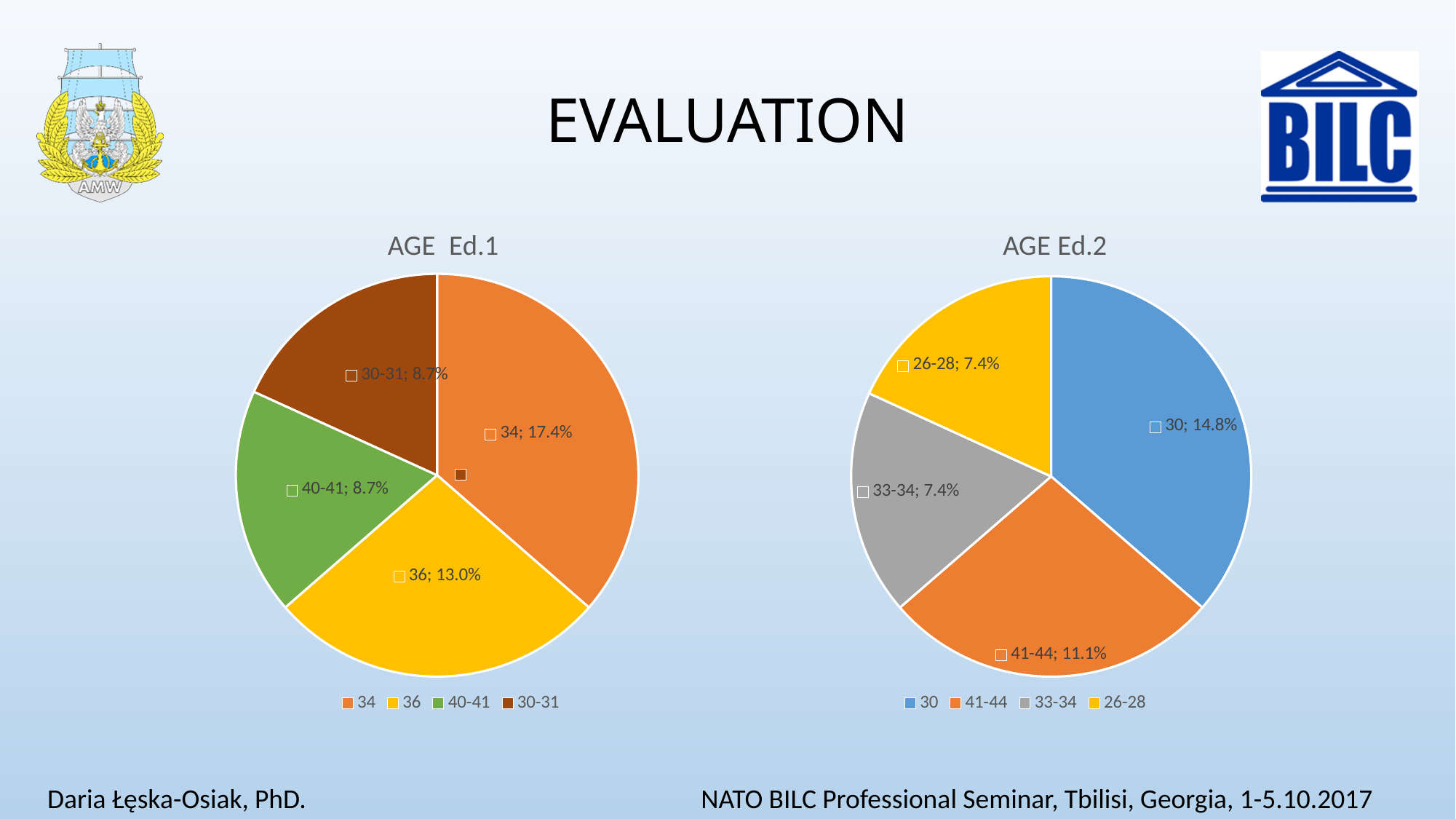
In the "AGE Ed.2" chart, what is the difference between the values for 30 and 41-44? 3.7% In the "AGE Ed.1" chart, what value is labelled for the 34 slice? 17.4% In the "AGE Ed.1" chart, what value is labelled for the 36 slice? 13.0% In the "AGE Ed.2" chart, which is larger, the value for 41-44 or the value for 33-34? 41-44 In the "AGE Ed.2" chart, what value is labelled for the 30 slice? 14.8% In the "AGE Ed.2" chart, which category has the largest slice? 30 In the "AGE Ed.1" chart, what is the difference between the values for 34 and 36? 4.4% In the "AGE Ed.2" chart, what value is labelled for the 41-44 slice? 11.1% In the "AGE Ed.1" chart, which category has the largest slice? 34 How many slices does the "AGE Ed.1" chart have? 4 What type of chart is the "AGE Ed.1" chart? pie chart How many entries does the legend of the "AGE Ed.2" chart list? 4